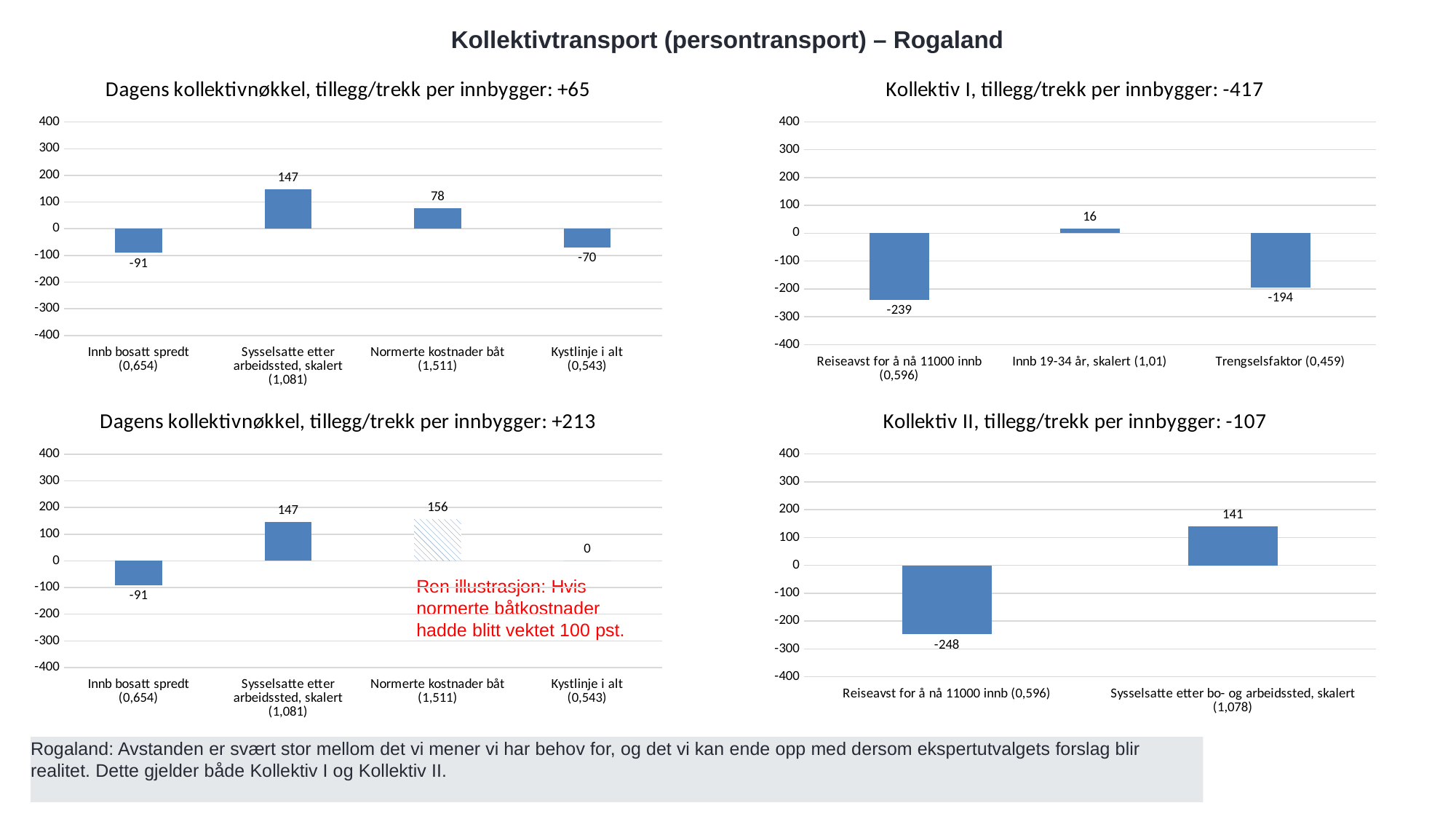
In the Kollektiv II chart, which is larger: the value for Reiseavst for å nå 11000 innb (0,596) or Sysselsatte etter bo- og arbeidssted, skalert (1,078)? Sysselsatte etter bo- og arbeidssted, skalert (1,078) What kind of chart is the Kollektiv II chart? Bar chart In the Kollektiv I chart, what is the value for Trengselsfaktor (0,459)? -194 In the top-left chart (Dagens kollektivnøkkel, +65), what is the value for Sysselsatte etter arbeidssted, skalert (1,081)? 147 In the top-left chart (Dagens kollektivnøkkel, +65), which category has the lowest value? Innb bosatt spredt (0,654) In the Kollektiv I chart, which category has the highest value? Innb 19-34 år, skalert (1,01) How many categories are shown in the Kollektiv I chart? 3 In the top-left chart (Dagens kollektivnøkkel, +65), what is the value for Innb bosatt spredt (0,654)? -91 In the bottom-left chart (Dagens kollektivnøkkel, +213), what is the value for Kystlinje i alt (0,543)? 0 In the Kollektiv II chart, what is the value for Reiseavst for å nå 11000 innb (0,596)? -248 In the top-left chart (Dagens kollektivnøkkel, +65), what is the difference between the values for Normerte kostnader båt (1,511) and Kystlinje i alt (0,543)? 148 In the bottom-left chart (Dagens kollektivnøkkel, +213), what is the value for Normerte kostnader båt (1,511)? 156